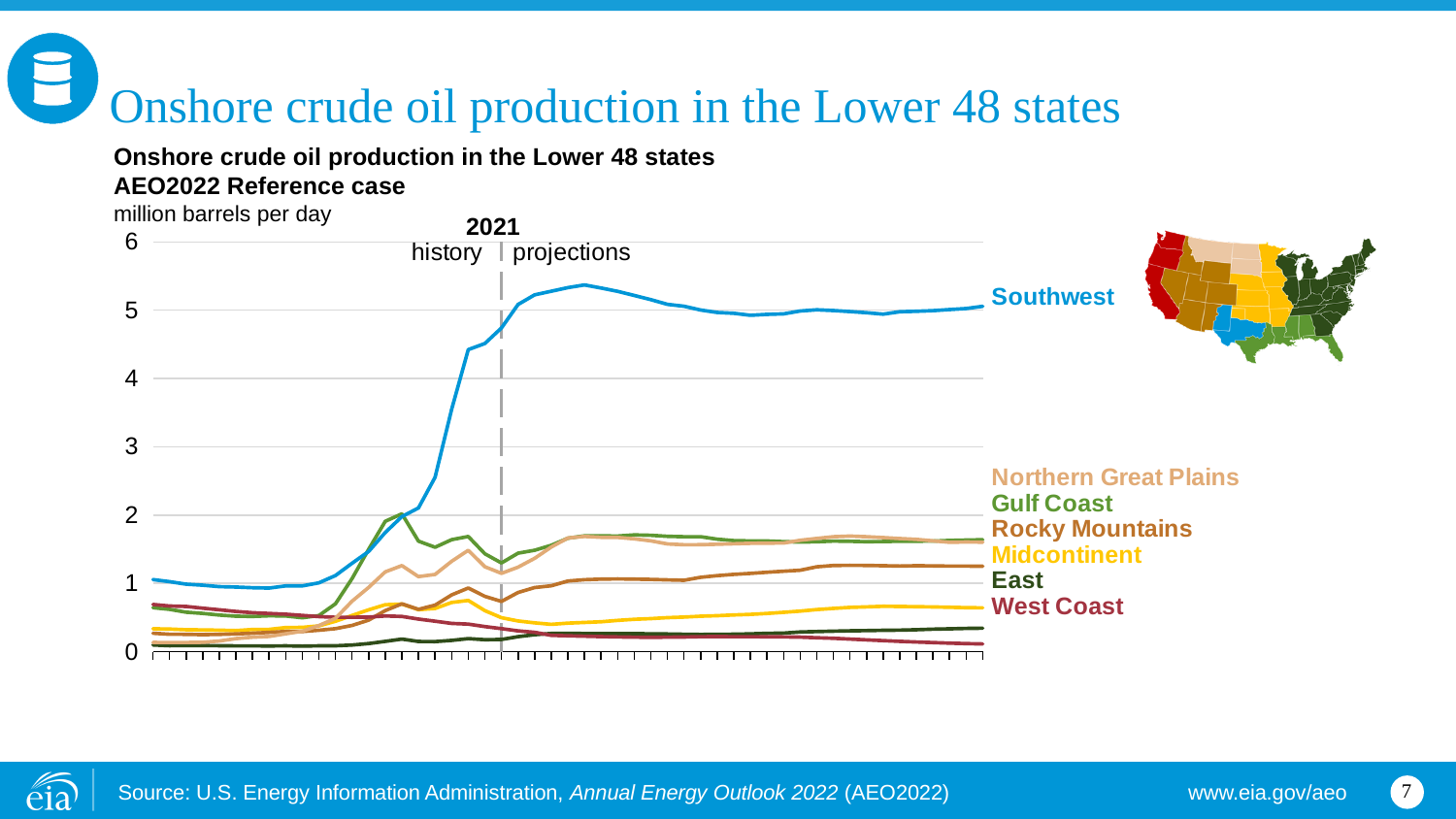
At the end of the projection period, which is larger: Midcontinent or East production? Midcontinent Is the Southwest value in 2021 greater or less than 4 million barrels per day? greater At the end of the projection period, which is larger: Southwest or Gulf Coast production? Southwest Does the West Coast line rise or fall over the period shown? fall Is the Gulf Coast value at the end of the projection period greater or less than 2 million barrels per day? less Which region has the highest onshore crude oil production at the end of the projection period? Southwest Is the peak value of the Southwest line greater or less than 5 million barrels per day? greater What year separates history from projections on the chart? 2021 What kind of chart is shown on the slide? line chart How many regions (series) are labelled on the chart? 7 Which region has the lowest onshore crude oil production at the end of the projection period? West Coast